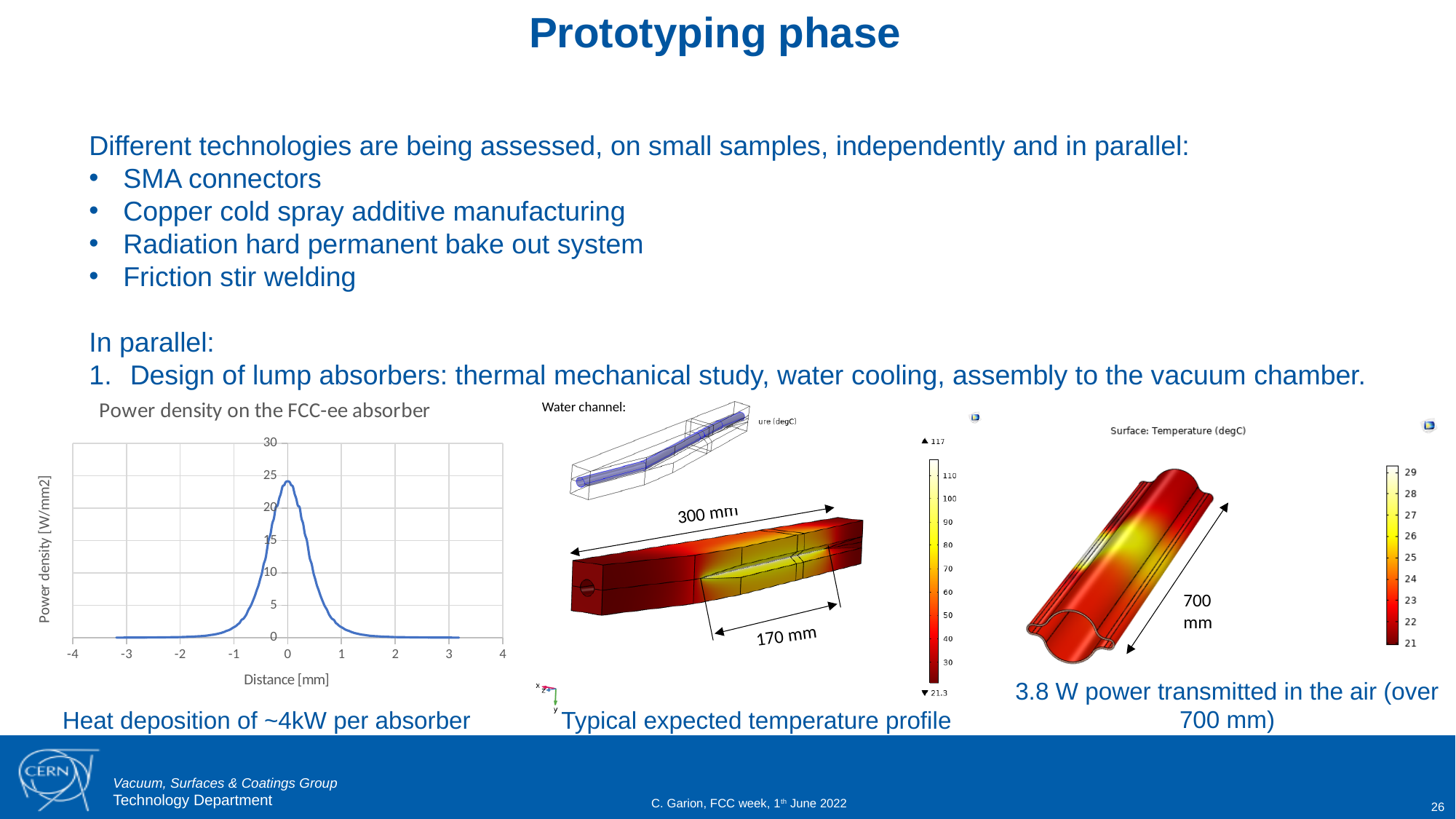
In the 'Power density on the FCC-ee absorber' chart, does the power density rise or fall as the distance goes from 0 mm to 4 mm? fall In the 'Power density on the FCC-ee absorber' chart, is the power density at a distance of -1 mm greater or less than 5? less In the 'Power density on the FCC-ee absorber' chart, is the power density at a distance of 1 mm greater or less than 10? less In the 'Power density on the FCC-ee absorber' chart, is the peak power density greater or less than 20? greater What is the title of the chart on the left of the slide? Power density on the FCC-ee absorber What is the label of the x axis of the 'Power density on the FCC-ee absorber' chart? Distance [mm] In the 'Power density on the FCC-ee absorber' chart, is the power density at a distance of 0 mm larger or smaller than at a distance of 2 mm? larger In the 'Power density on the FCC-ee absorber' chart, at what distance does the power density reach its maximum? 0 In the 'Power density on the FCC-ee absorber' chart, what is the highest value shown on the y axis? 30 What kind of chart is 'Power density on the FCC-ee absorber'? line chart How many data series are plotted in the 'Power density on the FCC-ee absorber' chart? 1 In the 'Power density on the FCC-ee absorber' chart, does the power density rise or fall as the distance goes from -4 mm to 0 mm? rise